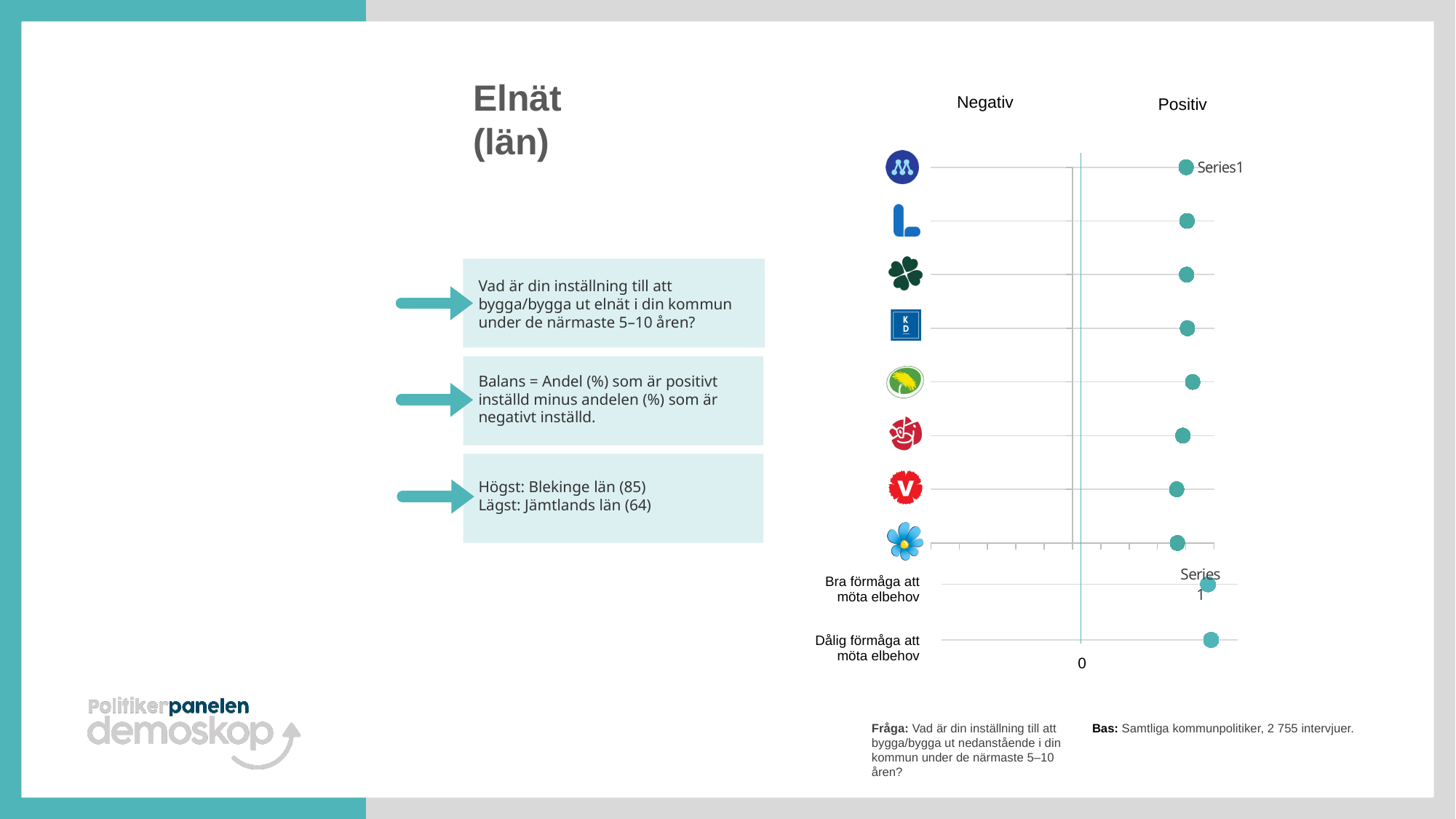
Is the value for 'Bra förmåga att möta elbehov' greater or less than 0? greater How many data points are plotted in the chart? 10 What are the two labels shown above the chart indicating the direction of the axis? Negativ and Positiv What kind of chart is shown on the slide? dot plot Is the value for 'Dålig förmåga att möta elbehov' greater or less than 0? greater Are all the plotted points on the positive or the negative side of the 0 line? positive